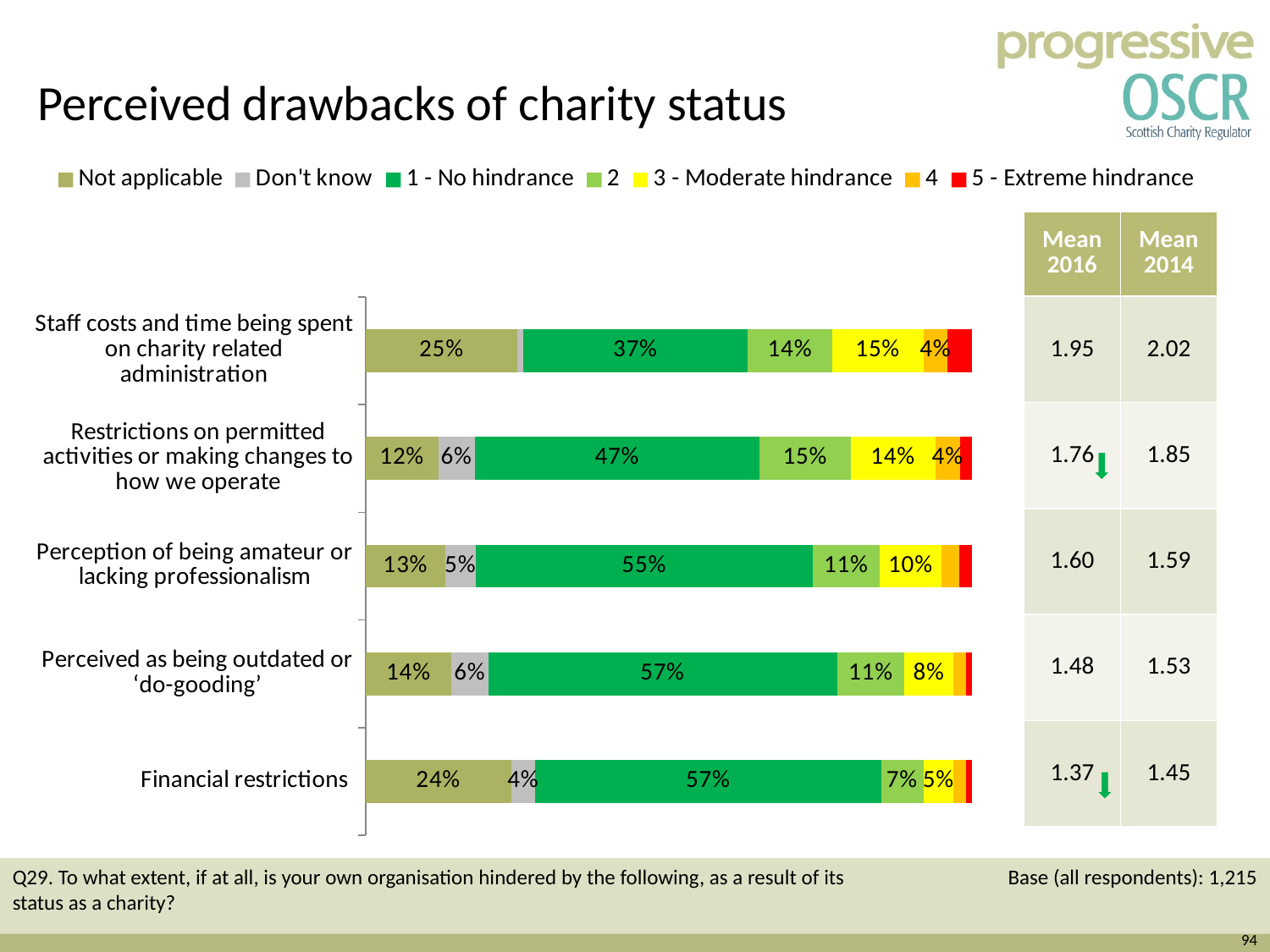
What percentage of respondents said '1 - No hindrance' for 'Restrictions on permitted activities or making changes to how we operate'? 47% Which category has the lowest 'Not applicable' value? Restrictions on permitted activities or making changes to how we operate Which has the larger value for series '2': 'Restrictions on permitted activities or making changes to how we operate' or 'Financial restrictions'? Restrictions on permitted activities or making changes to how we operate How many series does the chart legend list? 7 What is the '3 - Moderate hindrance' value for 'Financial restrictions'? 5% What kind of chart is shown on the slide? Stacked bar chart What is the difference in the '1 - No hindrance' value between 'Perception of being amateur or lacking professionalism' and 'Staff costs and time being spent on charity related administration'? 18 percentage points Which category has the highest '3 - Moderate hindrance' value? Staff costs and time being spent on charity related administration What is the 'Not applicable' value for 'Staff costs and time being spent on charity related administration'? 25% According to the table beside the chart, what is the Mean 2016 value for 'Financial restrictions'? 1.37 How many drawback categories are plotted in the chart? 5 What colour represents '5 - Extreme hindrance' in the chart legend? Red